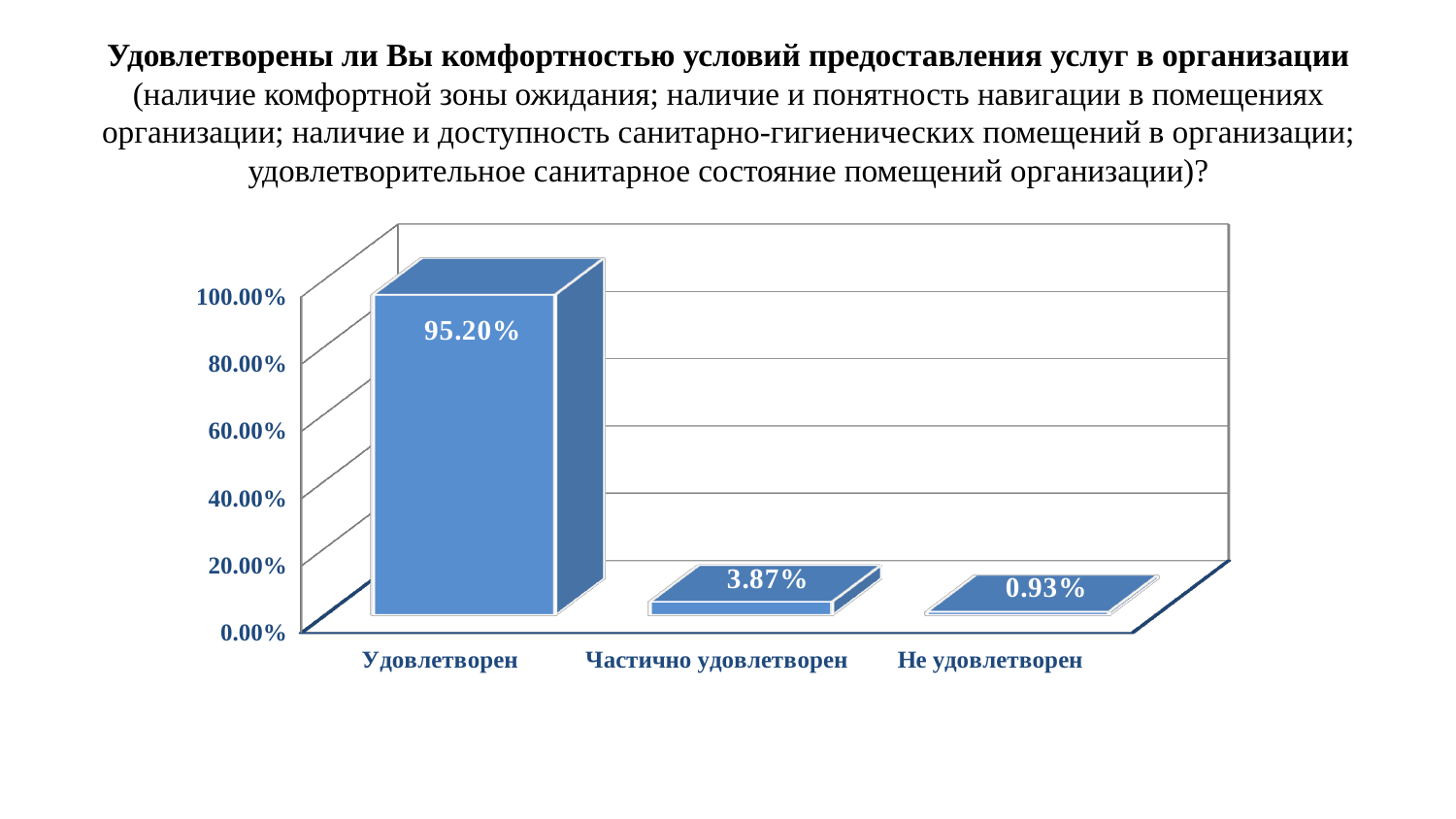
Is the value for Удовлетворен greater or less than 80.00%? greater Which category has the highest value? Удовлетворен What is the difference between the values for Частично удовлетворен and Не удовлетворен? 2.94% What is the value for Частично удовлетворен? 3.87% Do the values rise or fall from left to right along the x axis? fall What kind of chart is shown on the slide? bar chart What is the value for Удовлетворен? 95.20% How many categories are shown on the x axis? 3 What is the difference between the values for Удовлетворен and Частично удовлетворен? 91.33% What is the value for Не удовлетворен? 0.93% Which category has the lowest value? Не удовлетворен Which is larger, the value for Частично удовлетворен or the value for Не удовлетворен? Частично удовлетворен